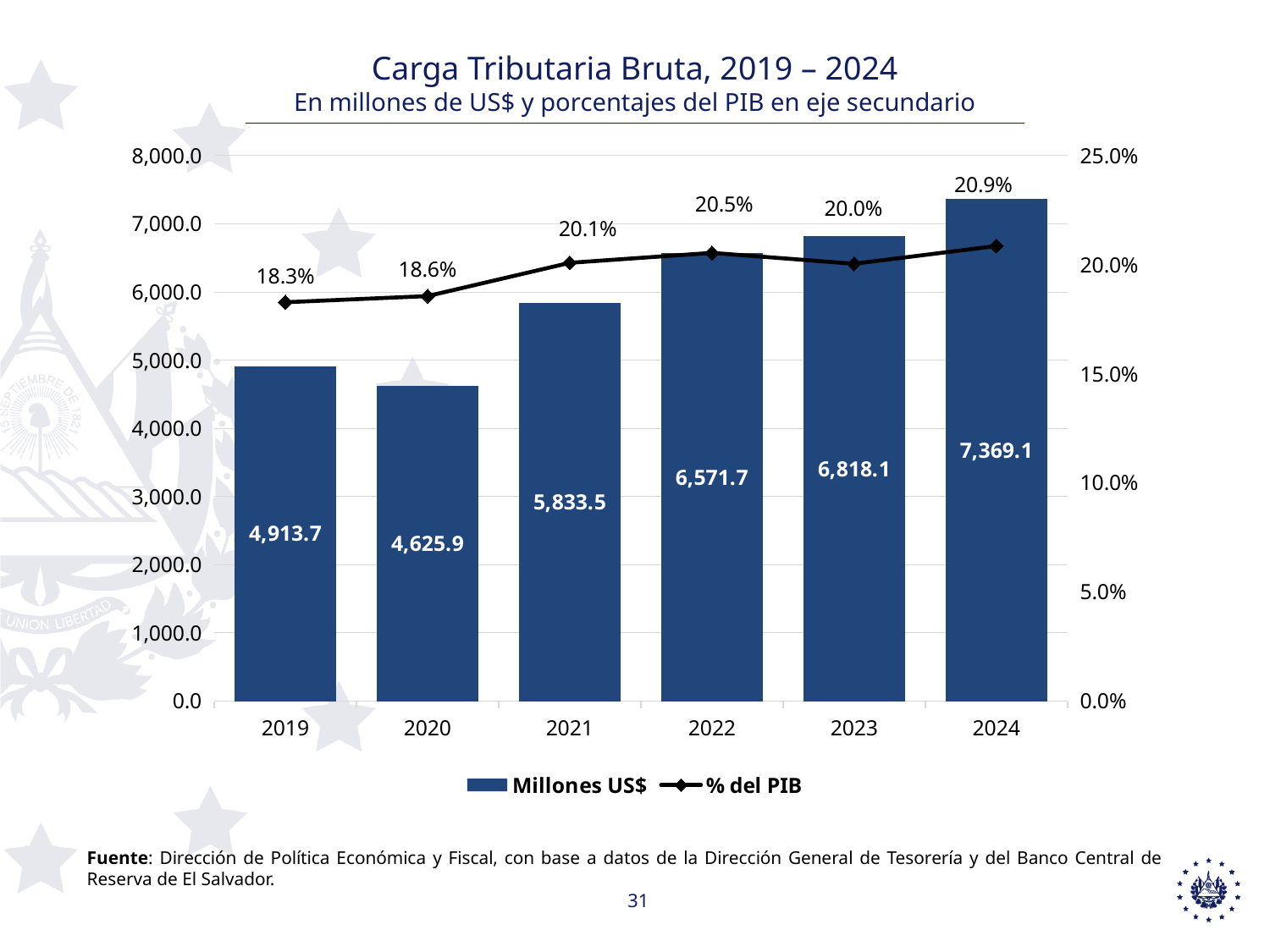
Which year has the lowest Millones US$ value? 2020 Which year has the lowest % del PIB value? 2019 Which year has the highest Millones US$ value? 2024 What is the value of Millones US$ for 2024? 7,369.1 How many years are shown on the x axis? 6 Is the Millones US$ value for 2022 greater or less than 6,000.0? greater What is the title of the chart? Carga Tributaria Bruta, 2019 – 2024 What is the % del PIB value for 2019? 18.3% How many series does the legend list? 2 What is the value of Millones US$ for 2021? 5,833.5 What is the difference in Millones US$ between 2024 and 2023? 551.0 Which is larger, the Millones US$ value for 2019 or for 2020? 2019